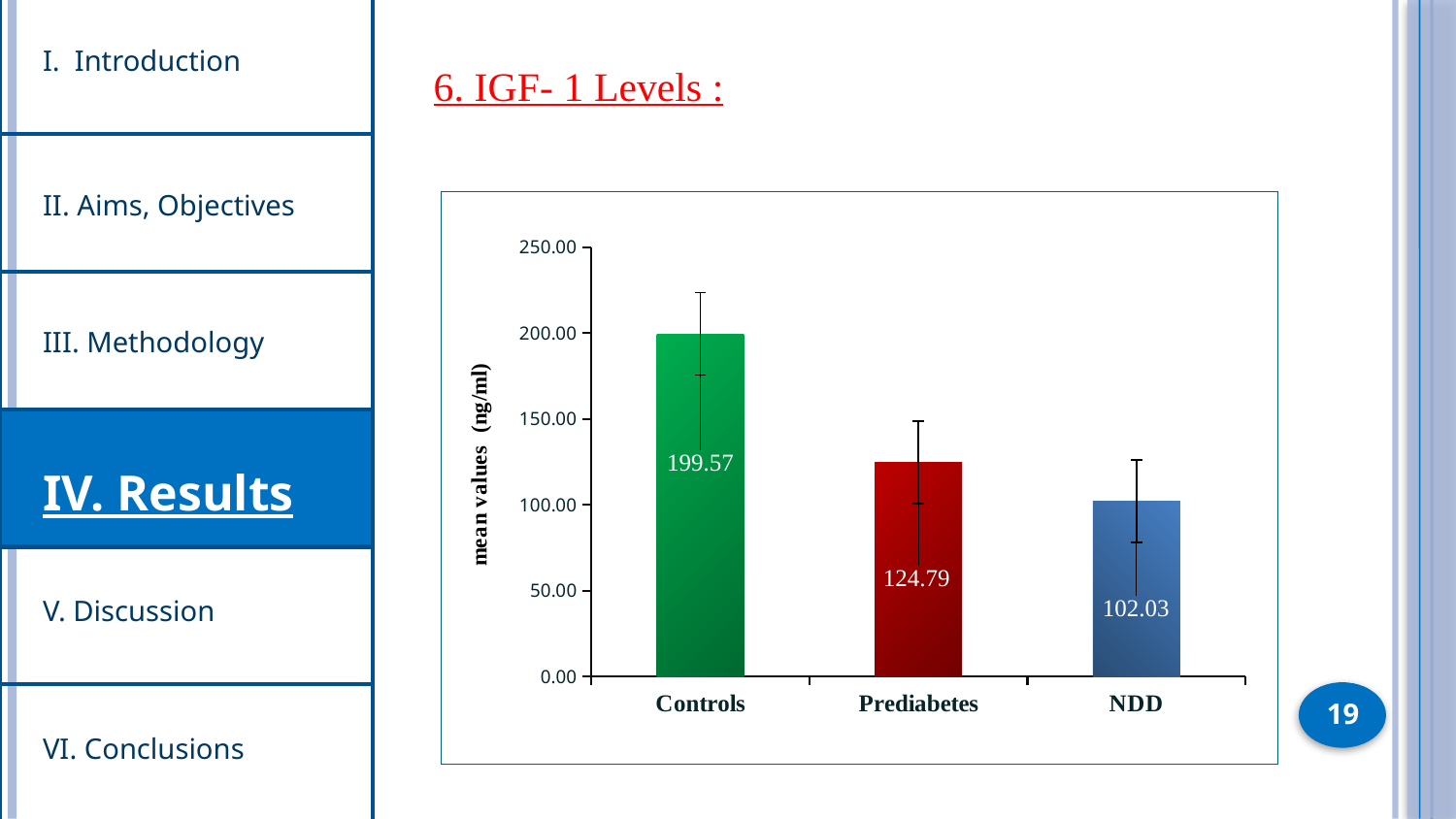
Is the mean value for Controls greater or less than 150.00? greater What kind of chart is shown on the slide? Bar chart What is the label of the y axis? mean values (ng/ml) Which group has the lowest mean IGF-1 value? NDD What is the difference between the mean values for Prediabetes and NDD? 22.76 Which is larger, the mean value for Prediabetes or for NDD? Prediabetes How many groups are shown on the x axis? 3 What is the mean IGF-1 value for Controls? 199.57 What is the mean IGF-1 value for NDD? 102.03 What is the mean IGF-1 value for Prediabetes? 124.79 Which group has the highest mean IGF-1 value? Controls What is the difference between the mean values for Controls and NDD? 97.54